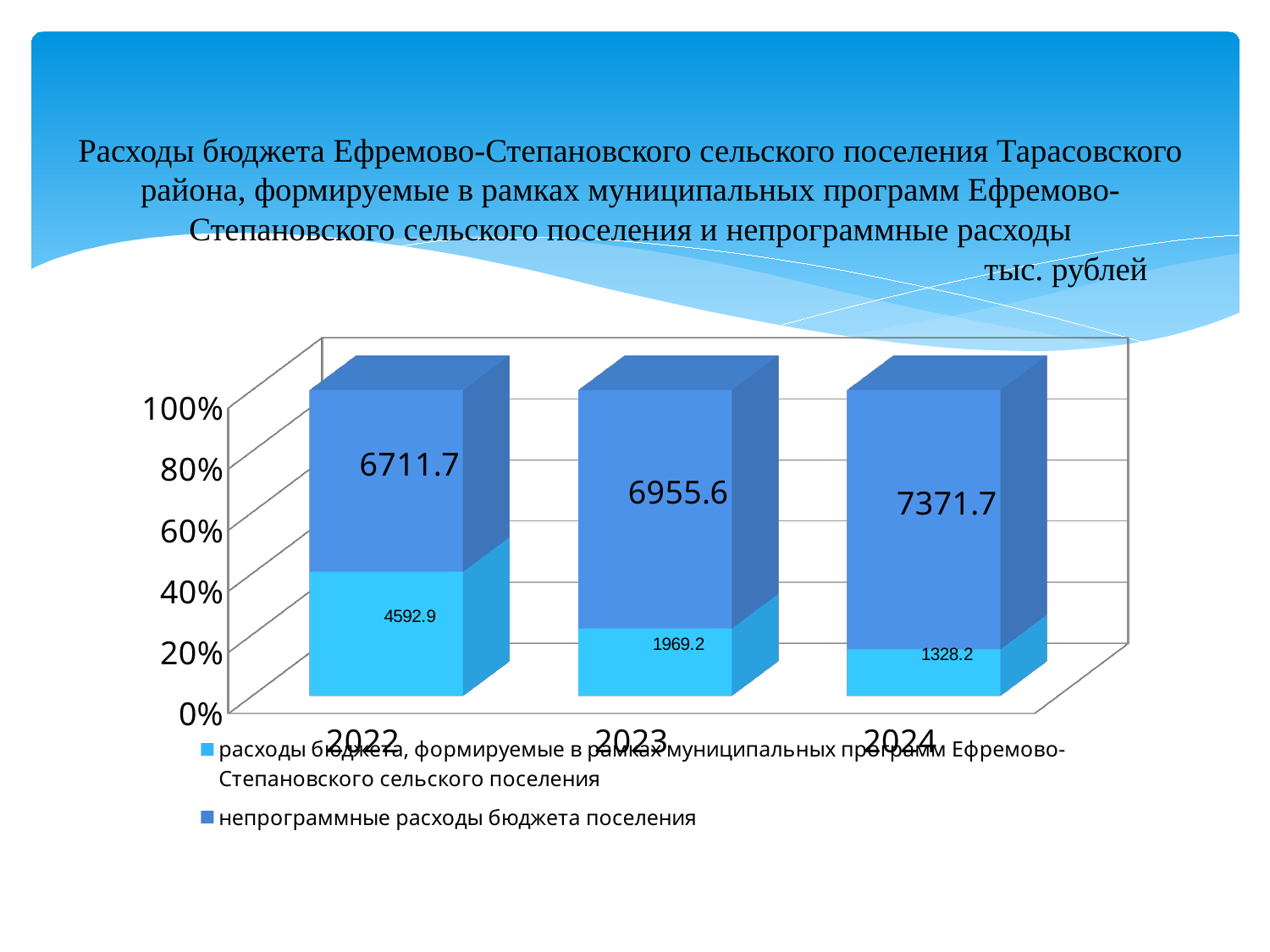
What is the value for расходы бюджета, формируемые в рамках муниципальных программ in 2024? 1328.2 In which year is the value for непрограммные расходы бюджета поселения the highest? 2024 By how much does the value for непрограммные расходы бюджета поселения in 2024 exceed that in 2022? 660.0 How many series does the legend list? 2 How many years are shown on the x axis? 3 What is the value for непрограммные расходы бюджета поселения in 2022? 6711.7 What is the value for расходы бюджета, формируемые в рамках муниципальных программ in 2023? 1969.2 Which is larger in 2023: непрограммные расходы бюджета поселения or расходы в рамках муниципальных программ? непрограммные расходы бюджета поселения What is the total of the stacked bar for 2023? 8924.8 What is the difference between непрограммные расходы and программные расходы in 2022? 2118.8 Do the values for расходы бюджета, формируемые в рамках муниципальных программ rise or fall from 2022 to 2024? fall In which year is the value for расходы бюджета, формируемые в рамках муниципальных программ the lowest? 2024